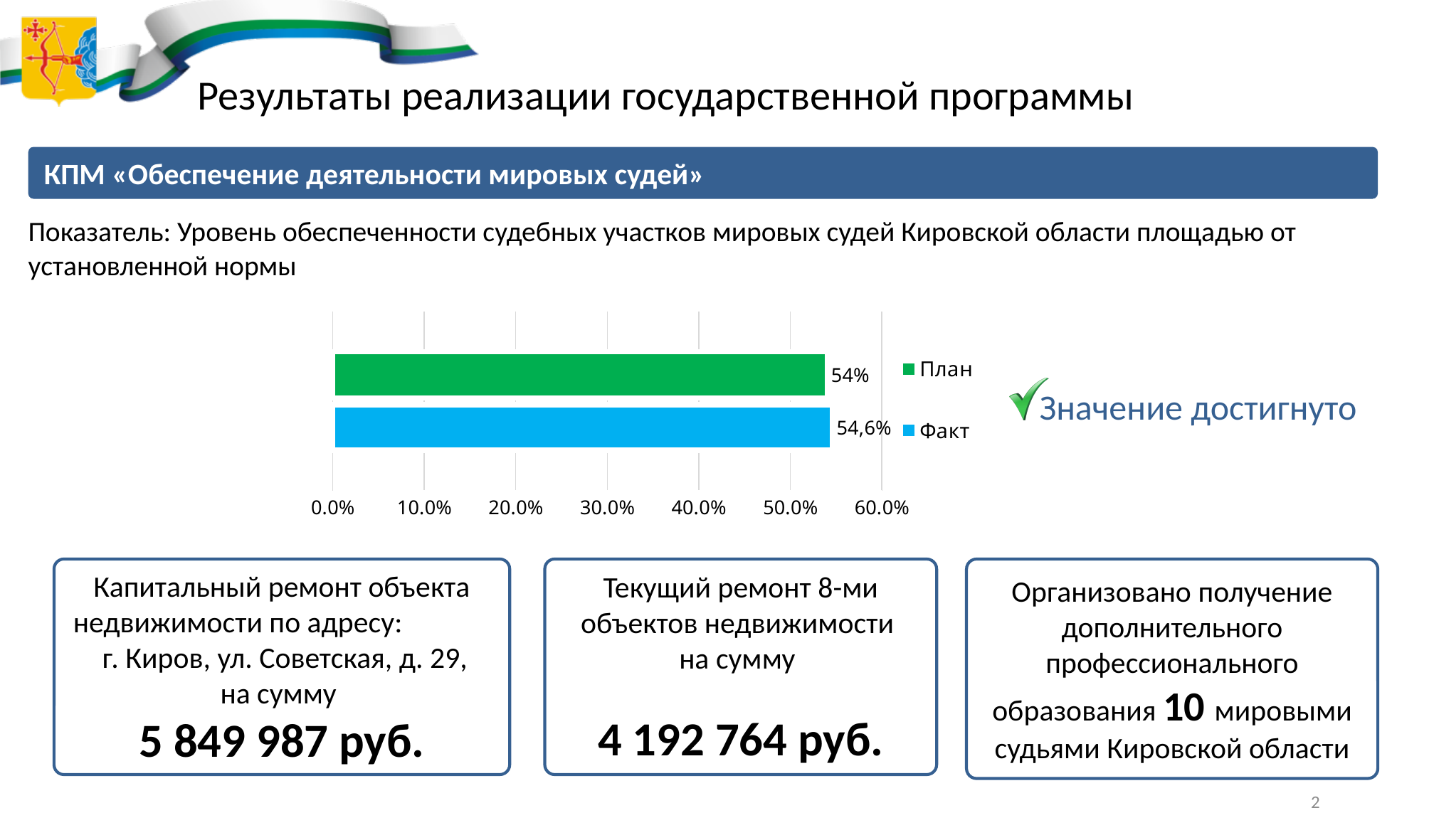
How many bars are plotted in the chart? 2 What colour is the План series in the legend? green Is the value for Факт greater or less than 60.0%? less Is the value for План greater or less than 50.0%? greater Which series has the largest value in the chart? Факт What is the value of the Факт bar? 54,6% How many series does the legend list? 2 Which bar is higher, План or Факт? Факт What is the difference between the Факт value and the План value? 0,6% Which series has the smallest value in the chart? План What is the value of the План bar? 54% What kind of chart is shown on the slide? bar chart